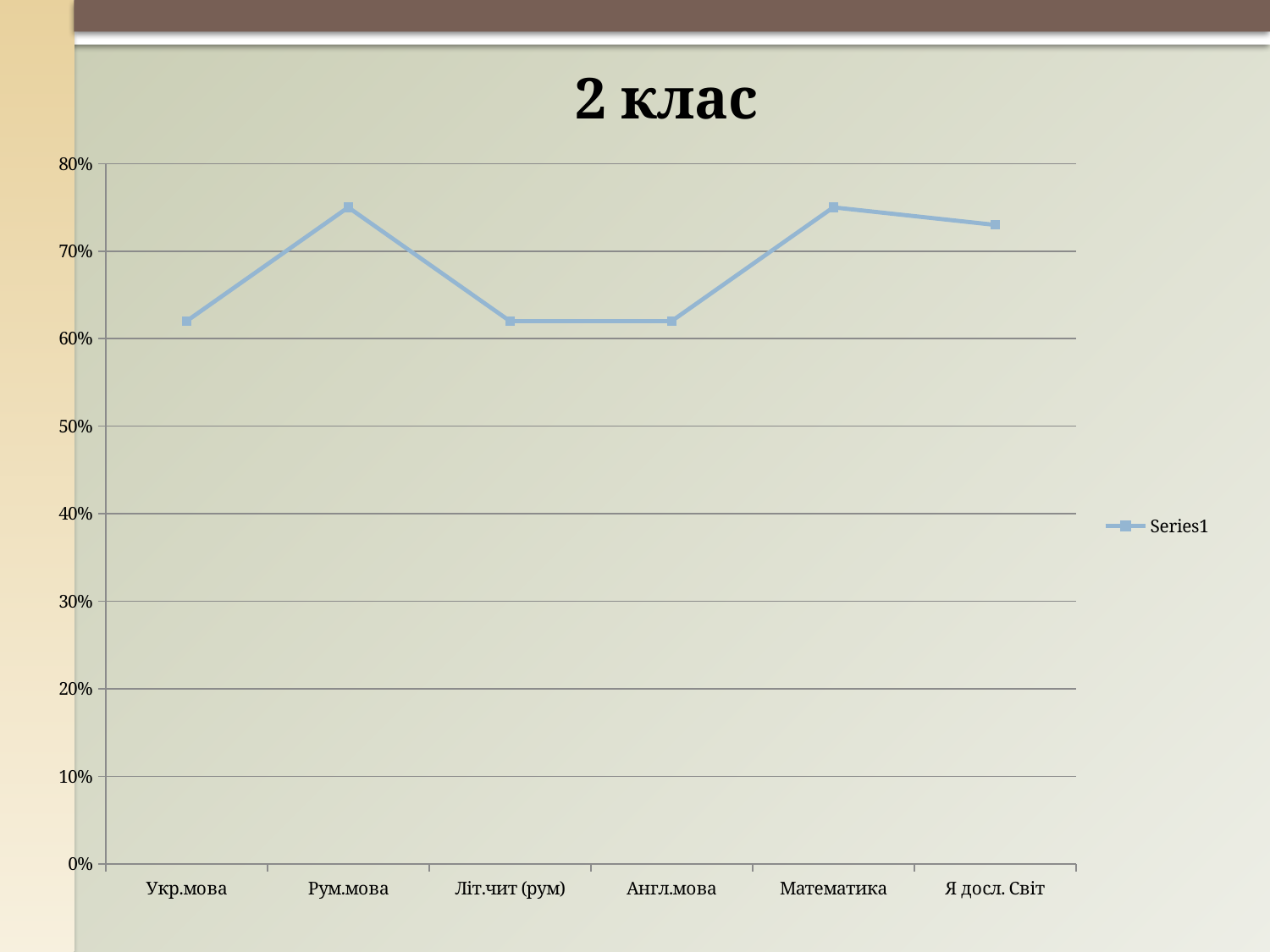
Is the value for Англ.мова greater or less than 70%? less Is the value for Математика greater or less than 80%? less What type of chart is shown on the slide? line chart What is the name of the series shown in the legend? Series1 Is the value for Рум.мова greater or less than 70%? greater How many series does the legend list? 1 How many categories are plotted along the x axis? 6 Does the line rise or fall from Математика to Я досл. Світ? fall Which is larger, the value for Рум.мова or the value for Укр.мова? Рум.мова What is the title of the chart? 2 клас Which is larger, the value for Математика or the value for Літ.чит (рум)? Математика